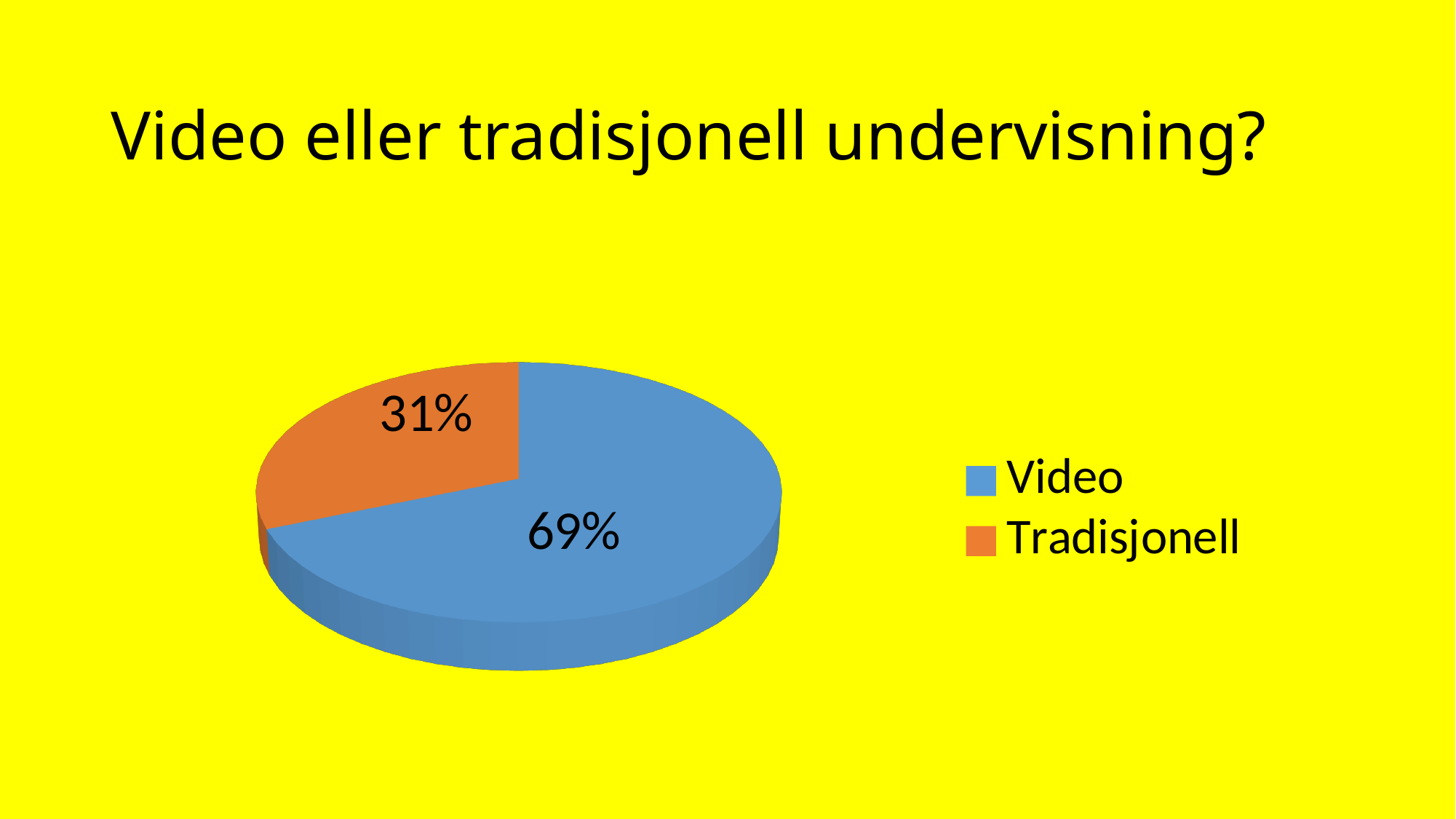
How many slices does the pie chart have? 2 What share of the pie does Tradisjonell have? 31% What is the difference in percentage points between the Video and Tradisjonell slices? 38 Which is larger, the Video slice or the Tradisjonell slice? Video What share of the pie does Video have? 69% Which category has the smallest slice of the pie? Tradisjonell How many entries does the legend list? 2 Which category has the largest slice of the pie? Video What kind of chart is shown on the slide? Pie chart What colour is the Tradisjonell slice? Orange What is the title of the slide? Video eller tradisjonell undervisning?